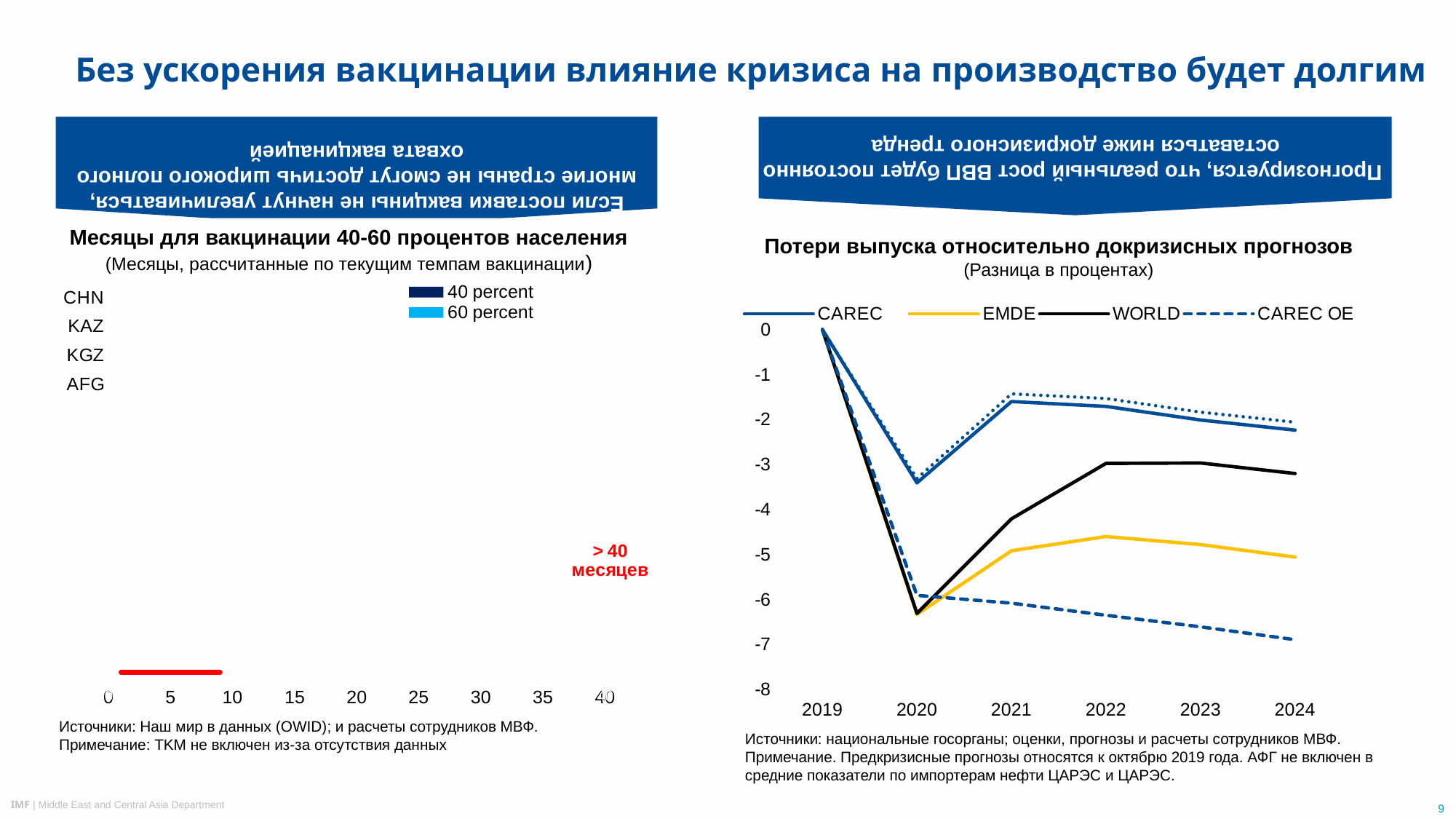
On the left chart (Месяцы для вакцинации 40-60 процентов населения), how many series does the legend list? 2 On the right chart, how many series does the legend list? 4 On the right chart, which series has the lowest value in 2024? CAREC OE On the right chart, how many years are shown on the x axis? 6 On the right chart, does the CAREC OE series rise or fall from 2020 to 2024? fall On the right chart, is the value for CAREC in 2020 greater or less than -3? less On the right chart (Потери выпуска относительно докризисных прогнозов), what kind of chart is it? line chart On the right chart, is the value for EMDE in 2022 greater or less than -5? greater On the right chart, is the value for CAREC OE in 2024 greater or less than -6? less On the right chart, which is higher in 2023, CAREC or EMDE? CAREC